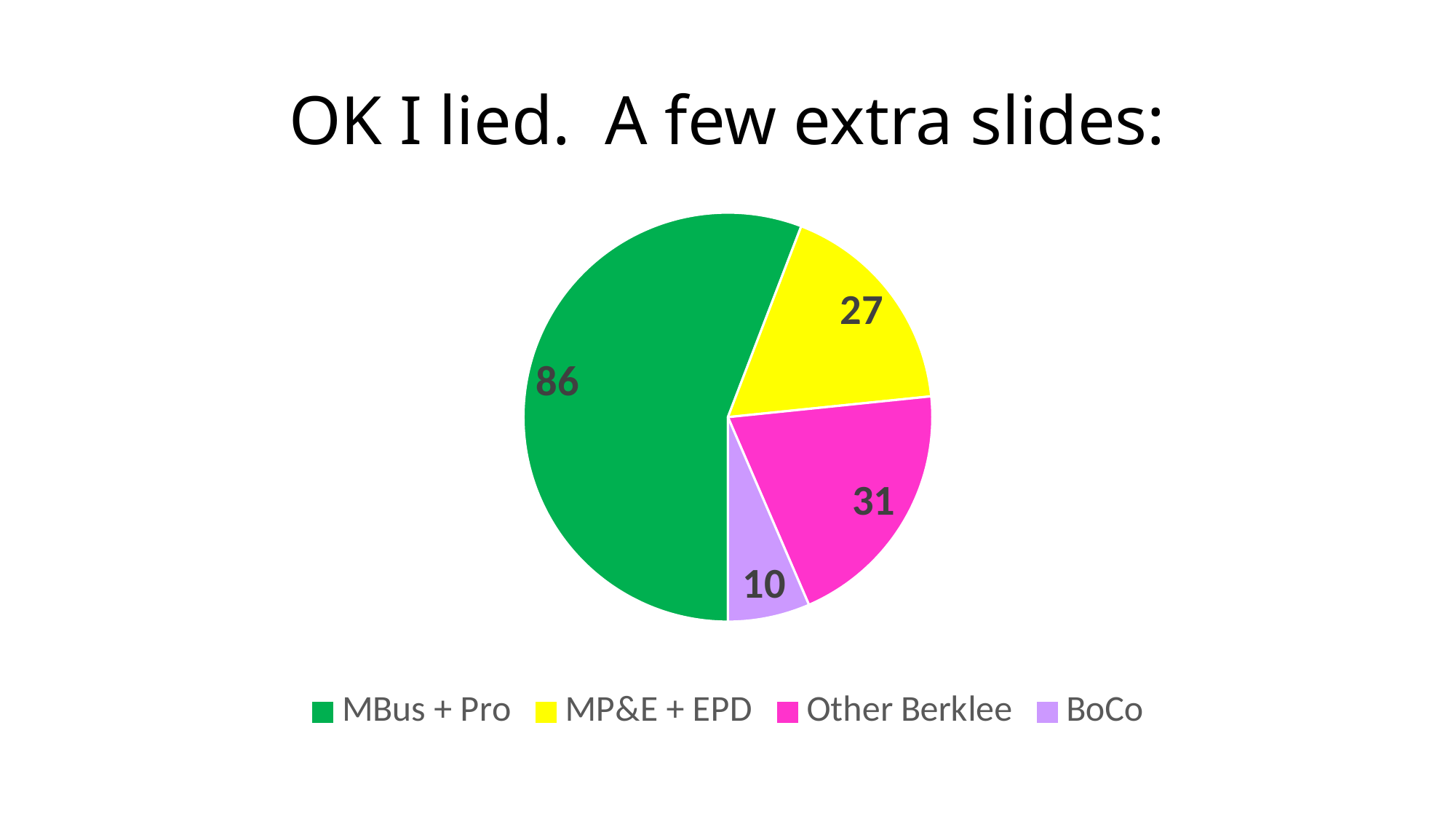
What is the total of all slices in the pie chart? 154 How many categories does the pie chart have? 4 What is the value for Other Berklee? 31 What is the value for MP&E + EPD? 27 What type of chart is shown on the slide? pie chart Which is larger, Other Berklee or MP&E + EPD? Other Berklee Which category has the largest slice? MBus + Pro What is the value for MBus + Pro? 86 What is the value for BoCo? 10 Which category has the smallest slice? BoCo What is the difference between the values for MBus + Pro and Other Berklee? 55